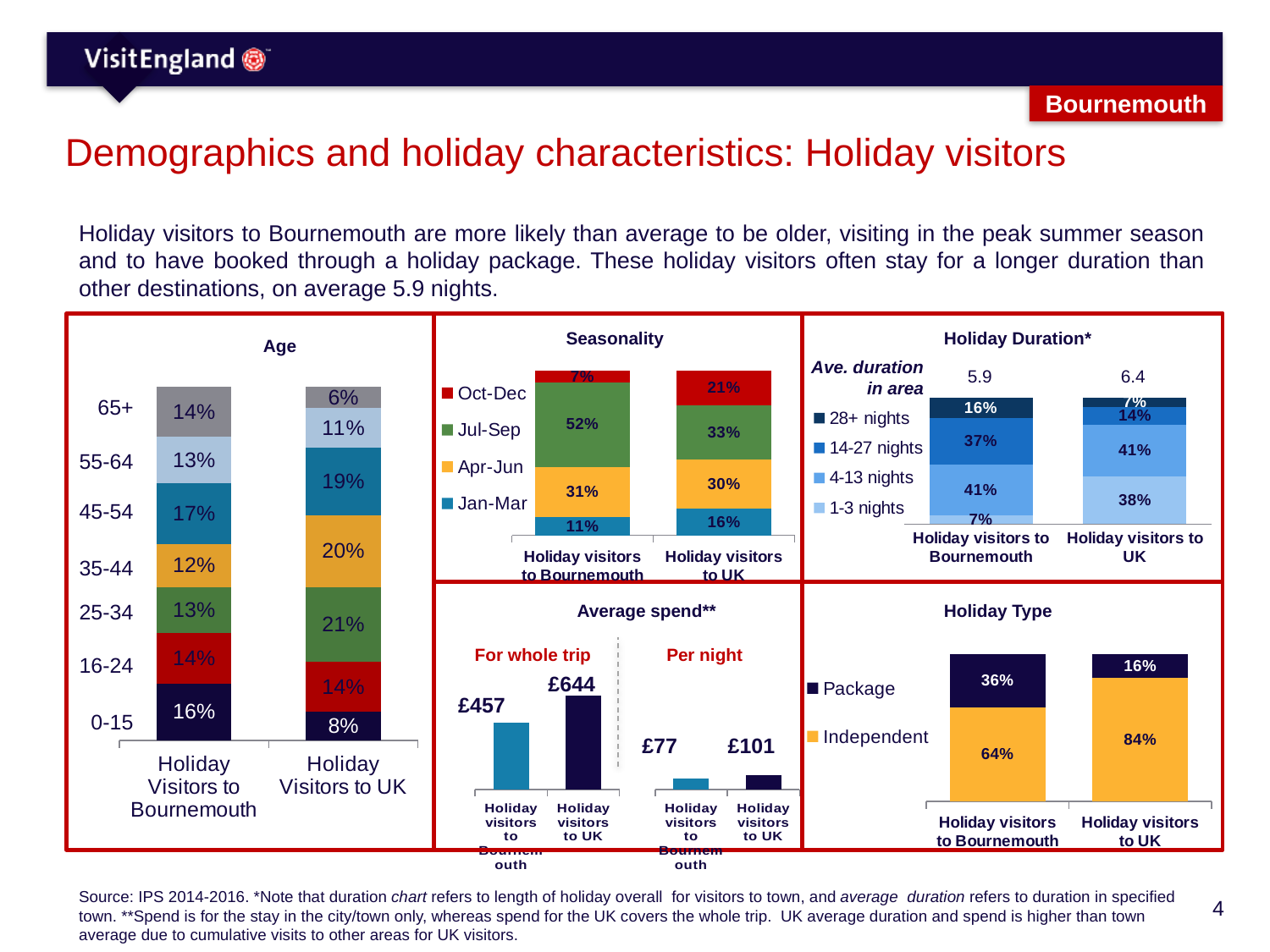
In the Age chart, which age group has the largest share among holiday visitors to UK? 25-34 In the Holiday Type chart, what share of holiday visitors to Bournemouth booked a package? 36% In the Average spend chart, what is the average spend for the whole trip for holiday visitors to Bournemouth? £457 In the Holiday Duration chart, what is the average duration in area for holiday visitors to Bournemouth? 5.9 In the Holiday Type chart, which group has the larger Independent share, holiday visitors to Bournemouth or holiday visitors to UK? Holiday visitors to UK In the Age chart, what percentage of holiday visitors to Bournemouth are aged 45-54? 17% In the Seasonality chart, what share of holiday visitors to Bournemouth visit in Jul-Sep? 52% In the Average spend chart, what is the difference in per night spend between holiday visitors to UK and holiday visitors to Bournemouth? £24 In the Holiday Duration chart, what share of holiday visitors to UK stay 1-3 nights? 38% In the Holiday Duration chart, how many series does the legend list? 4 In the Age chart, what is the difference between the 65+ share for holiday visitors to Bournemouth and for holiday visitors to UK? 8% In the Seasonality chart, which quarter has the lowest share for holiday visitors to Bournemouth? Oct-Dec